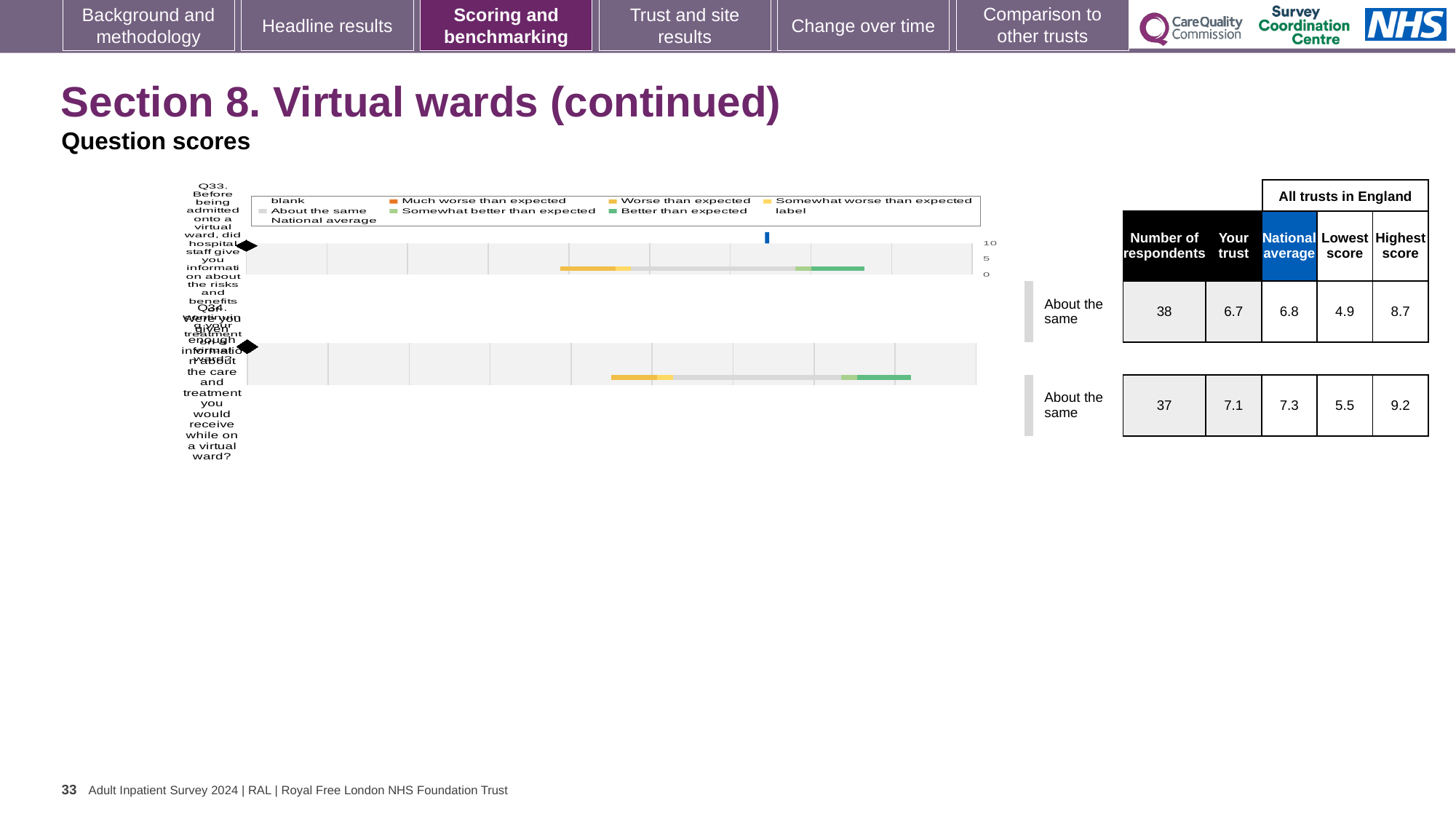
What is the highest score among all trusts in England for Q34? 9.2 What kind of chart is used to show the question scores on this slide? bar chart Which question had more respondents, Q33 or Q34? Q33 What is the national average score for Q34? 7.3 For Q34, which is larger: the 'Your trust' score or the national average? National average How many respondents answered Q33? 38 What is the difference between the 'Your trust' scores for Q34 and Q33? 0.4 What is the difference between the highest and lowest scores for Q33? 3.8 How many questions are plotted in the chart? 2 What benchmark category is shown for Q33? About the same What is the 'Your trust' score for Q33? 6.7 What is the lowest score among all trusts in England for Q33? 4.9